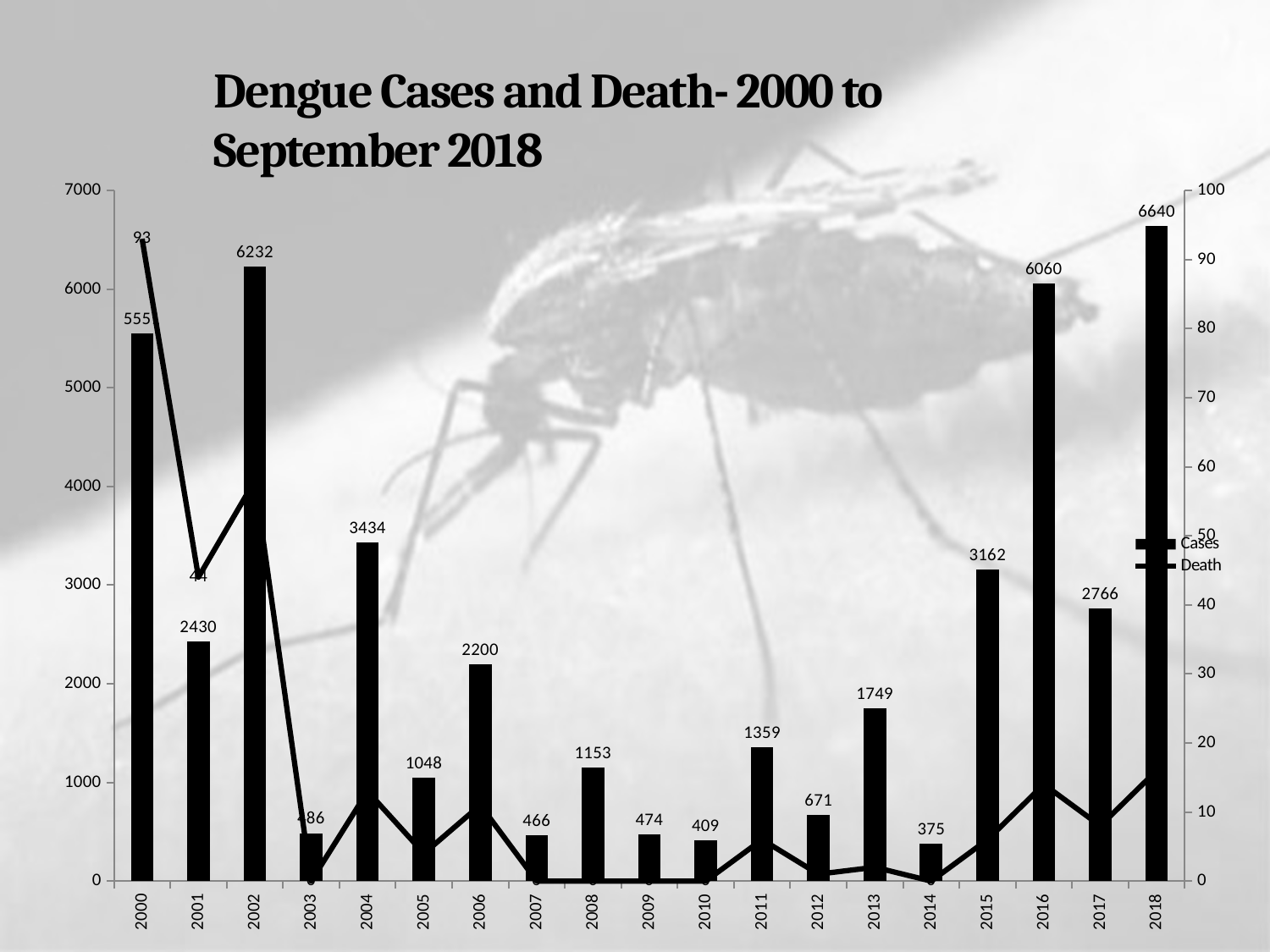
How many series does the legend list? 2 Which year has the lowest number of cases? 2014 What is the number of dengue cases in 2002? 6232 What is the number of deaths in 2001? 44 How many years are shown on the x axis? 19 Do the cases rise or fall from 2014 to 2016? rise What is the number of dengue cases in 2018? 6640 Which year had more cases, 2004 or 2015? 2004 What is the number of deaths in 2000? 93 Which year has the highest number of cases? 2018 What is the difference in cases between 2018 and 2016? 580 Is the number of deaths in 2016 greater or less than 20? less